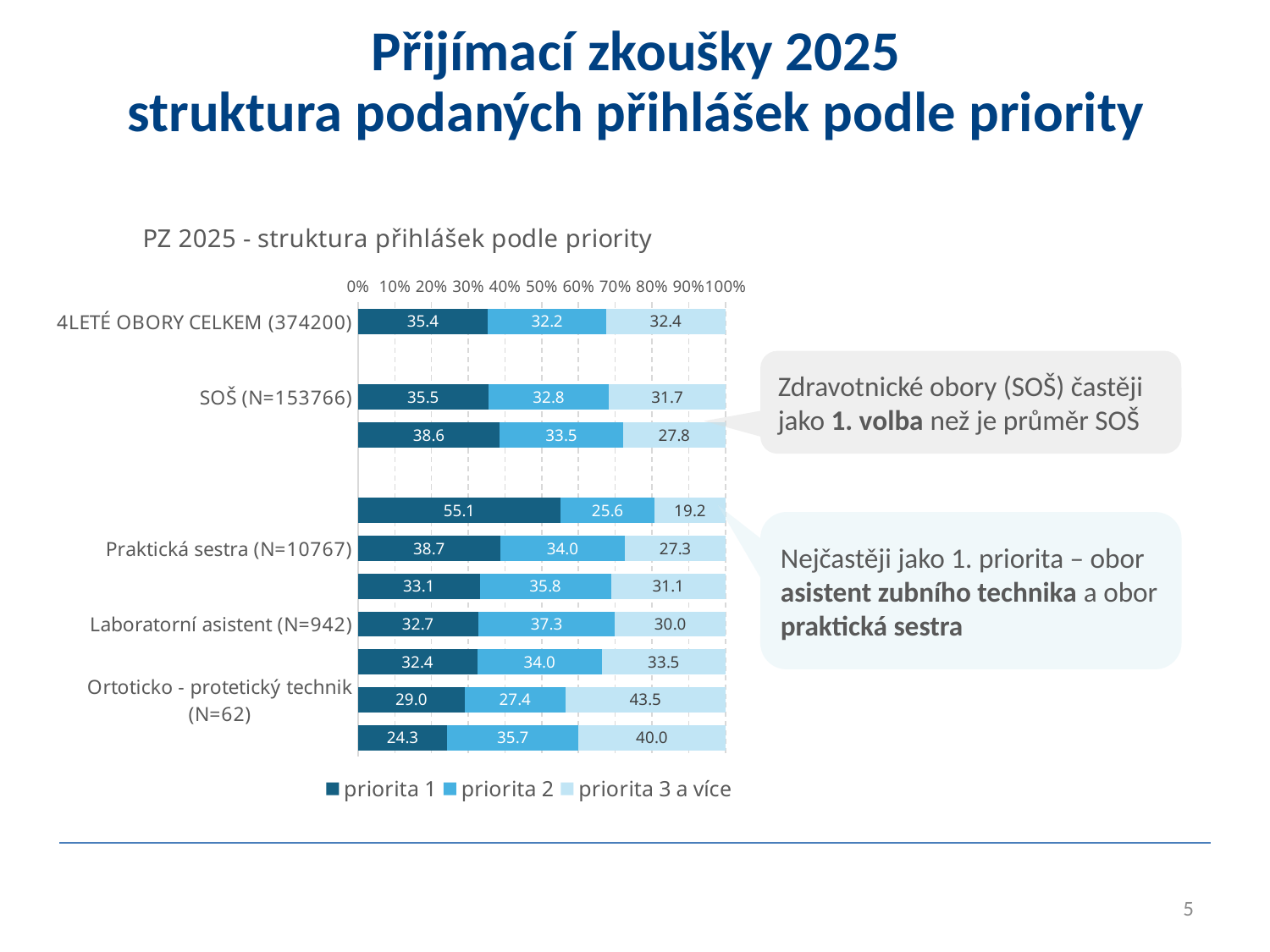
How much higher is the priorita 1 value for Praktická sestra (N=10767) than for SOŠ (N=153766)? 3.2 Which has a larger priorita 1 value: Laboratorní asistent (N=942) or Ortoticko - protetický technik (N=62)? Laboratorní asistent (N=942) What is the value of priorita 3 a více for Ortoticko - protetický technik (N=62)? 43.5 What is the value of priorita 2 for Laboratorní asistent (N=942)? 37.3 What is the value of priorita 2 for 4LETÉ OBORY CELKEM (374200)? 32.2 What is the title of the chart? PZ 2025 - struktura přihlášek podle priority What is the value of priorita 1 for SOŠ (N=153766)? 35.5 Which category has the highest value for priorita 3 a více? Ortoticko - protetický technik (N=62) What kind of chart is shown on the slide? Stacked bar chart What is the total of the three segments for the Praktická sestra (N=10767) bar? 100.0 What is the value of priorita 1 for Praktická sestra (N=10767)? 38.7 How many series does the legend list? 3